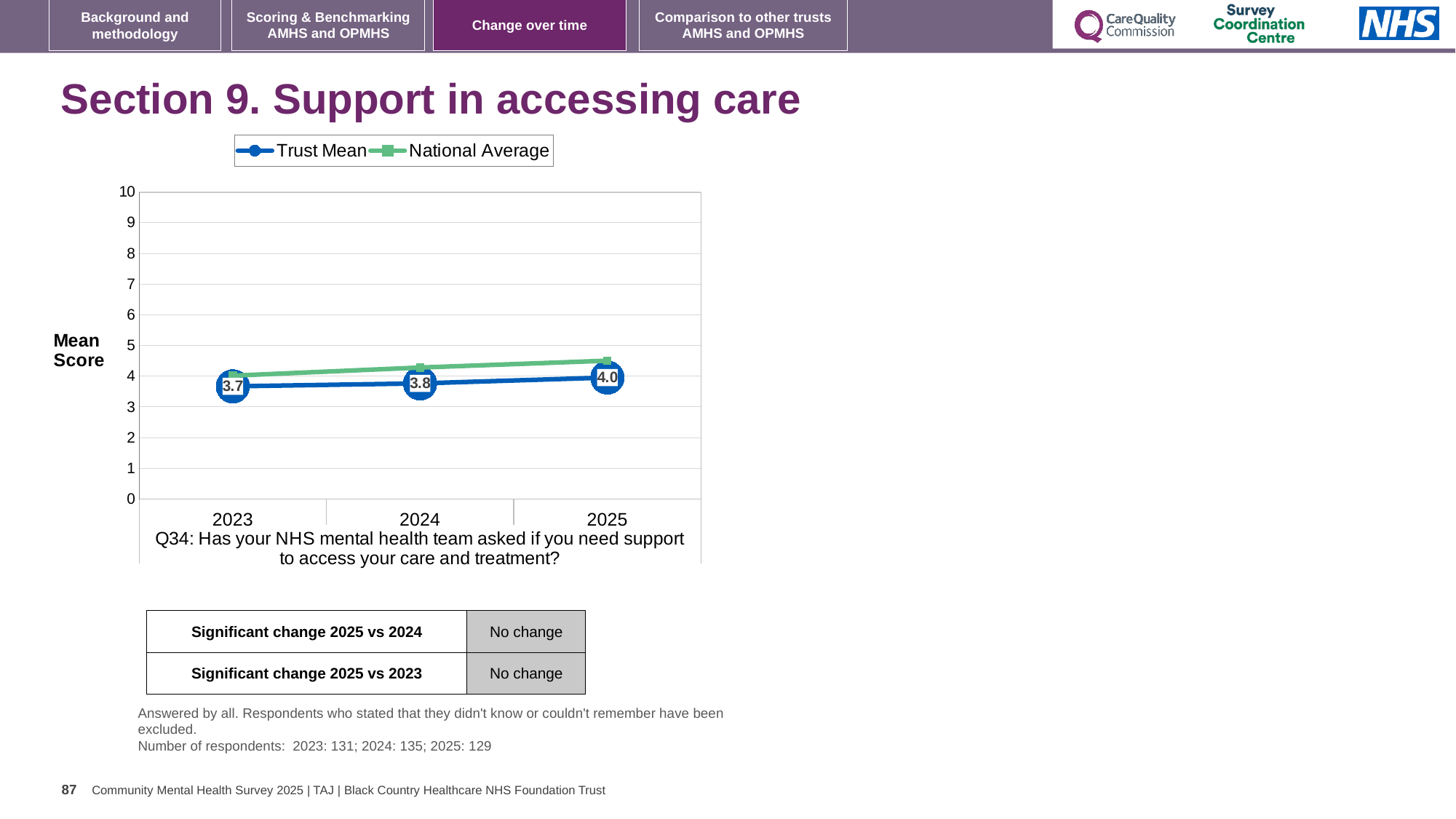
In which year is the Trust Mean score lowest? 2023 How many series does the legend list? 2 By how much did the Trust Mean score increase from 2023 to 2025? 0.3 In which year is the Trust Mean score highest? 2025 What kind of chart is shown on the slide? Line chart Is the National Average value for 2025 greater or less than 5? less What is the Trust Mean score for 2023? 3.7 What is the Trust Mean score for 2025? 4.0 Does the Trust Mean rise or fall from 2023 to 2025? Rise What is the Trust Mean score for 2024? 3.8 How many years are plotted on the x axis? 3 Which is larger in 2025, the Trust Mean or the National Average? National Average